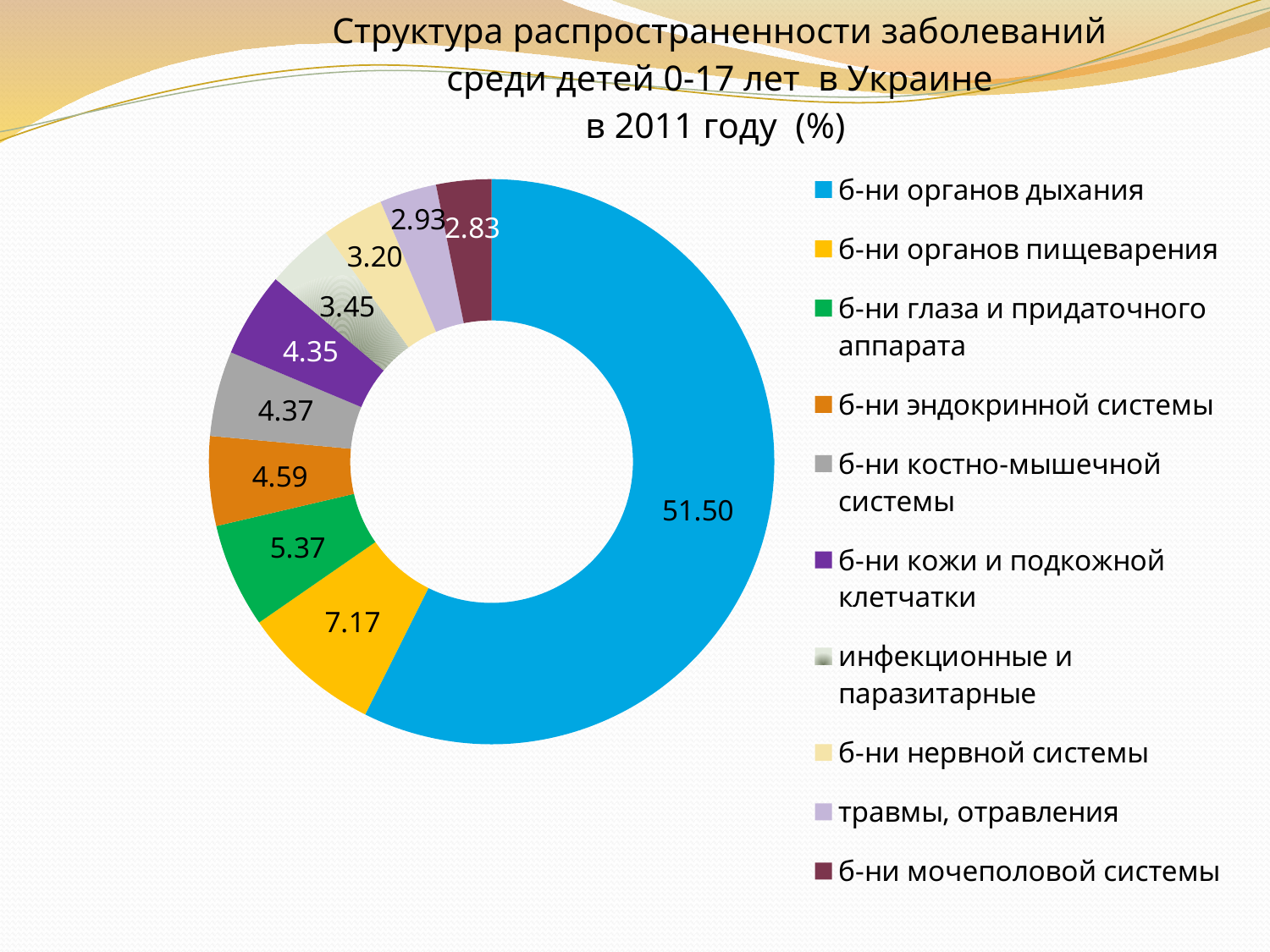
Which category has the smallest share of the chart? б-ни мочеполовой системы What is the value for б-ни органов пищеварения? 7.17 Which is larger: the value for б-ни кожи и подкожной клетчатки or the value for б-ни нервной системы? б-ни кожи и подкожной клетчатки What is the value for б-ни мочеполовой системы? 2.83 What is the value for б-ни органов дыхания? 51.50 What kind of chart is shown on the slide? Doughnut (pie) chart Which category has the largest share of the chart? б-ни органов дыхания What is the difference between the values for б-ни органов пищеварения and б-ни глаза и придаточного аппарата? 1.80 How many categories does the chart show? 10 What is the value for б-ни эндокринной системы? 4.59 What year does the chart title refer to? 2011 What is the value for инфекционные и паразитарные? 3.45